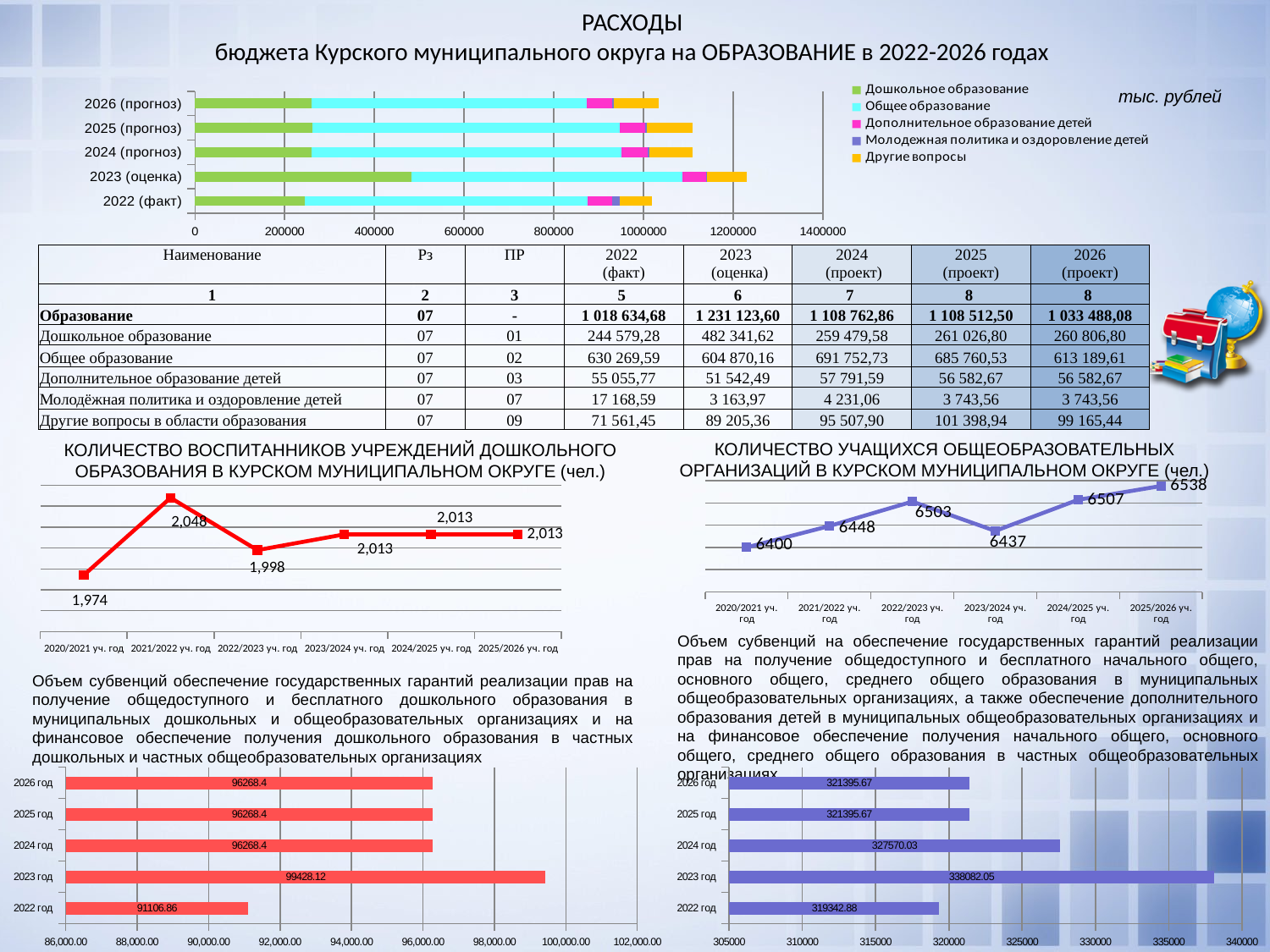
In the line chart 'КОЛИЧЕСТВО УЧАЩИХСЯ ОБЩЕОБРАЗОВАТЕЛЬНЫХ ОРГАНИЗАЦИЙ', what is the value for 2023/2024 уч. год? 6437 In the line chart 'КОЛИЧЕСТВО УЧАЩИХСЯ ОБЩЕОБРАЗОВАТЕЛЬНЫХ ОРГАНИЗАЦИЙ', what is the difference between the 2025/2026 and 2020/2021 values? 138 In the bottom-left bar chart of preschool subsidies, what is the value for 2023 год? 99428.12 In the top stacked bar chart of education expenditures, how many year categories are shown? 5 In the line chart 'КОЛИЧЕСТВО ВОСПИТАННИКОВ УЧРЕЖДЕНИЙ ДОШКОЛЬНОГО ОБРАЗОВАНИЯ', which academic year has the highest value? 2021/2022 уч. год In the bottom-left bar chart of preschool subsidies, which year has the lowest value? 2022 год In the line chart 'КОЛИЧЕСТВО ВОСПИТАННИКОВ УЧРЕЖДЕНИЙ ДОШКОЛЬНОГО ОБРАЗОВАНИЯ', what is the difference between the 2021/2022 and 2022/2023 values? 50 In the line chart 'КОЛИЧЕСТВО УЧАЩИХСЯ ОБЩЕОБРАЗОВАТЕЛЬНЫХ ОРГАНИЗАЦИЙ', which academic year has the lowest value? 2020/2021 уч. год In the line chart 'КОЛИЧЕСТВО ВОСПИТАННИКОВ УЧРЕЖДЕНИЙ ДОШКОЛЬНОГО ОБРАЗОВАНИЯ', what is the value for 2020/2021 уч. год? 1,974 In the top stacked bar chart of education expenditures, how many series does the legend list? 5 In the bottom-right bar chart of general education subsidies, what is the value for 2024 год? 327570.03 In the top stacked bar chart of education expenditures, which year has the longest total bar? 2023 (оценка)